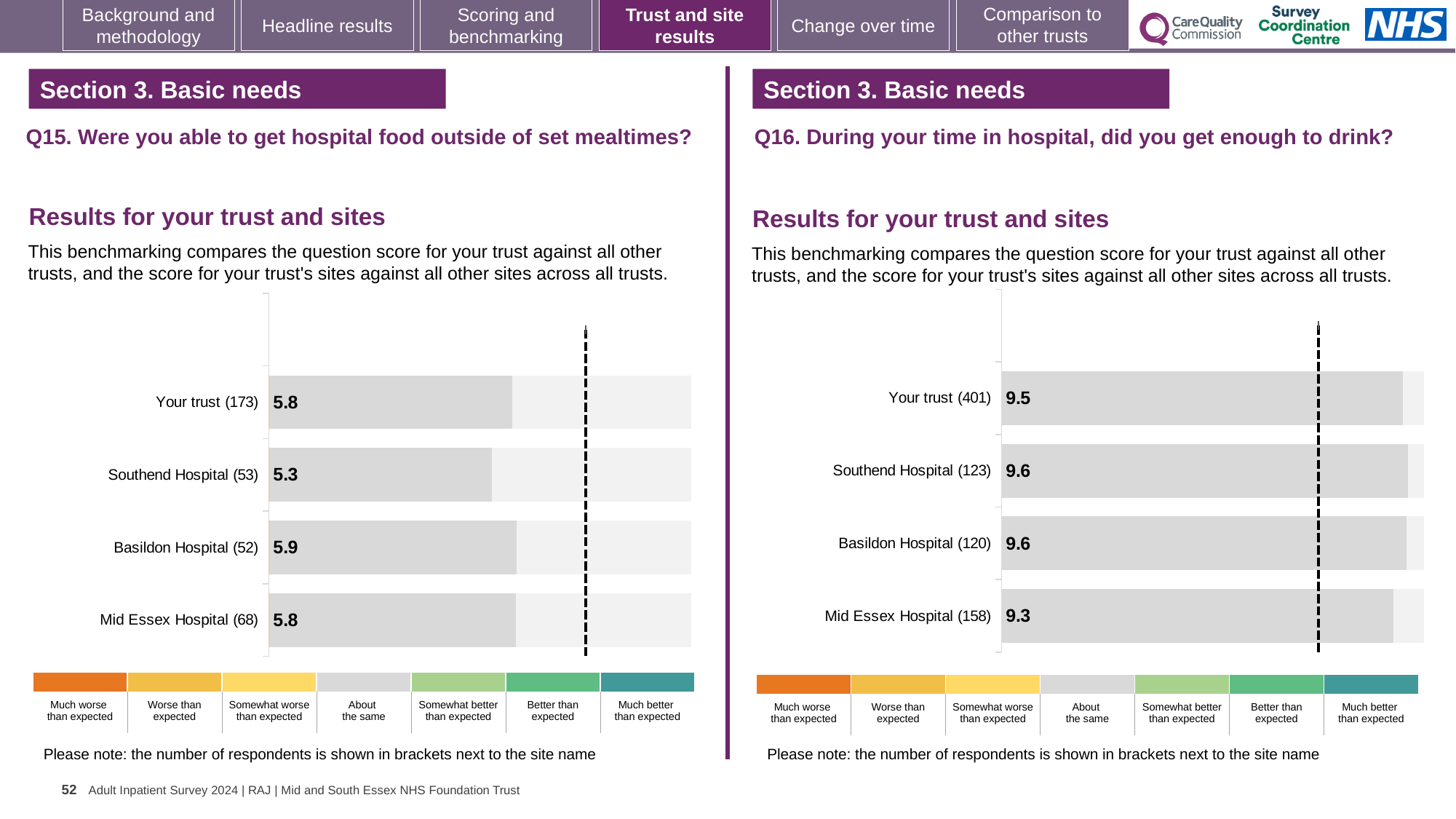
What kind of chart is used for the Q16 results on the right? Bar chart In the Q15 chart on the left, what is the score for Your trust? 5.8 In the Q16 chart on the right, what is the score for Your trust? 9.5 In the Q15 chart on the left, what is the score for Southend Hospital? 5.3 In the Q16 chart on the right, what is the score for Mid Essex Hospital? 9.3 In the Q16 chart on the right, what is the difference between the scores for Basildon Hospital and Your trust? 0.1 In the Q15 chart on the left, what is the difference between the scores for Basildon Hospital and Southend Hospital? 0.6 In the Q16 chart on the right, which is larger: the score for Southend Hospital or the score for Mid Essex Hospital? Southend Hospital How many bars are plotted in the Q15 chart on the left? 4 In the Q15 chart on the left, which site has the lowest score? Southend Hospital In the Q15 chart on the left, which site has the highest score? Basildon Hospital In the Q16 chart on the right, which site has the lowest score? Mid Essex Hospital